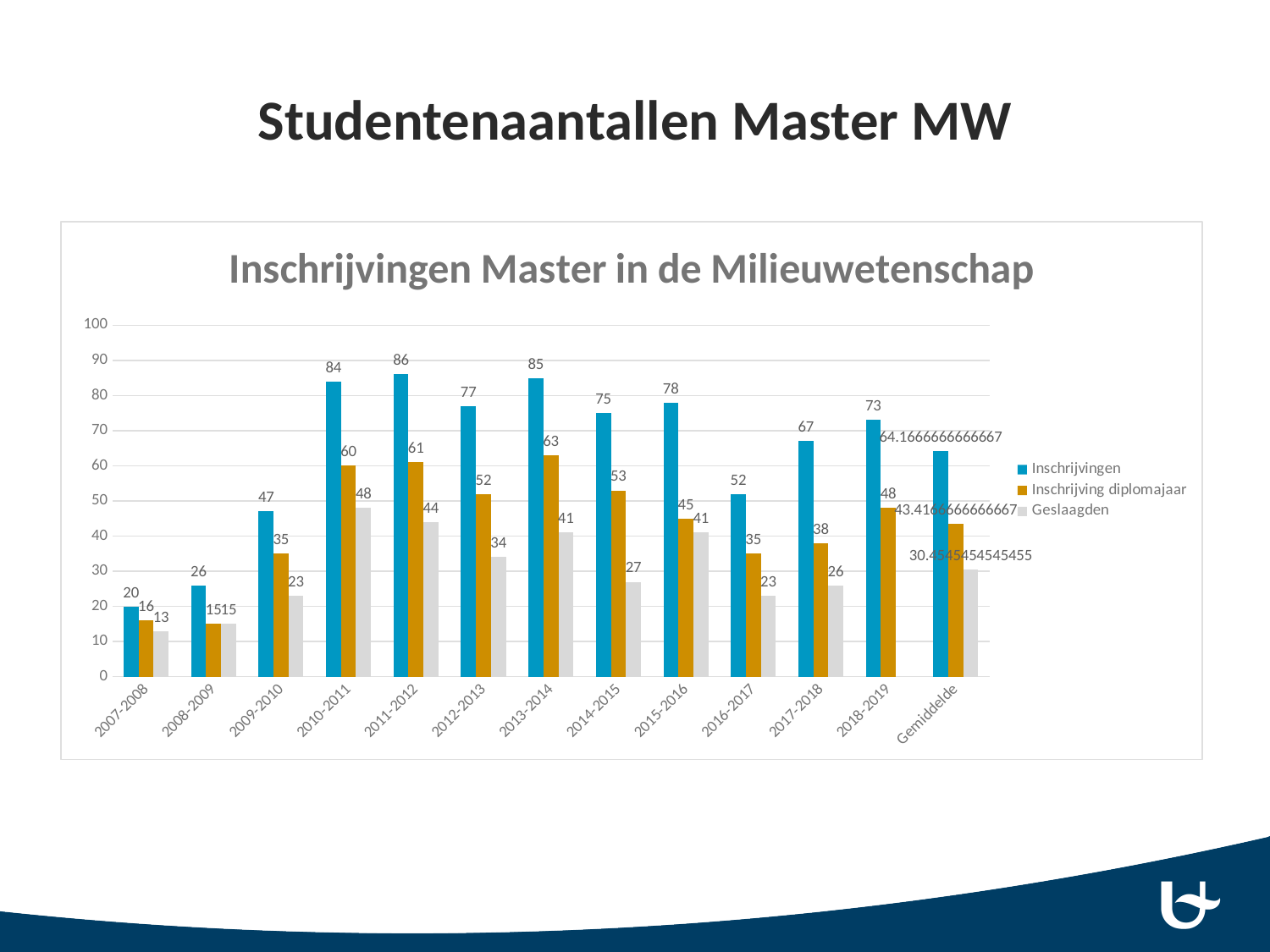
Which academic year has the lowest value for Inschrijvingen? 2007-2008 What kind of chart is shown on the slide? bar chart What is the value of Geslaagden for 2012-2013? 34 How many categories are shown on the x axis? 13 What is the value of Inschrijvingen for 2010-2011? 84 How many series does the legend list? 3 What is the Inschrijvingen value for Gemiddelde? 64.1666666666667 What is the difference between the Inschrijvingen values for 2011-2012 and 2010-2011? 2 Which has the larger Geslaagden value, 2010-2011 or 2011-2012? 2010-2011 What is the title of the chart? Inschrijvingen Master in de Milieuwetenschap What is the value of Inschrijving diplomajaar for 2013-2014? 63 Which academic year has the highest value for Inschrijvingen? 2011-2012